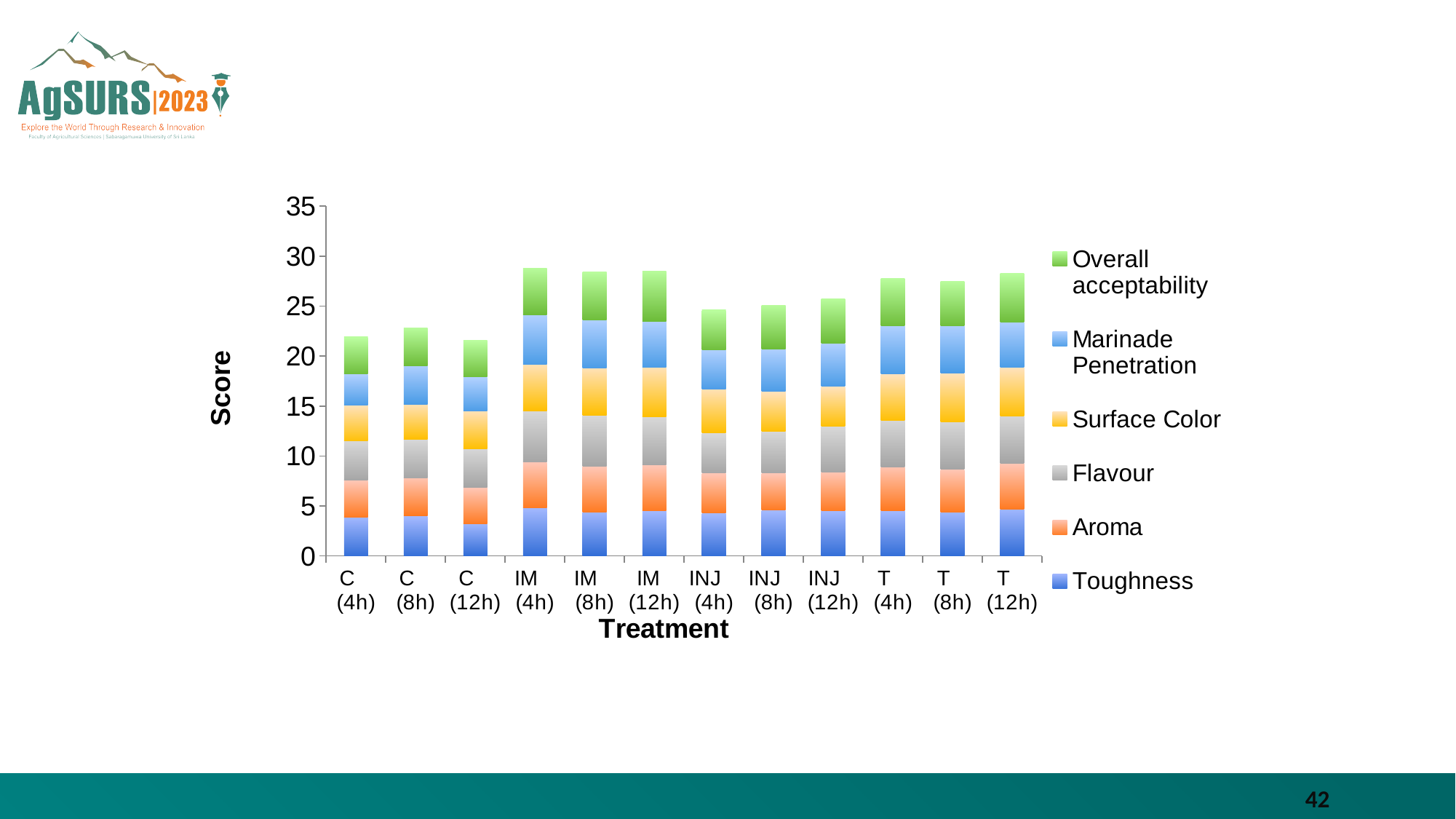
Is the total stacked score for C (4h) greater or less than 25? less Which series is shown in blue at the bottom of each stacked bar? Toughness What is the title of the vertical axis? Score Which has the larger total stacked score, C (8h) or INJ (8h)? INJ (8h) Which has the larger total stacked score, T (4h) or INJ (4h)? T (4h) How many treatment bars are plotted on the chart? 12 How many series does the legend list? 6 What kind of chart is shown on the slide? Stacked bar chart Which has the larger total stacked score, IM (4h) or C (4h)? IM (4h) Is the total stacked score for IM (4h) greater or less than 25? greater Is the total stacked score for C (12h) greater or less than 20? greater